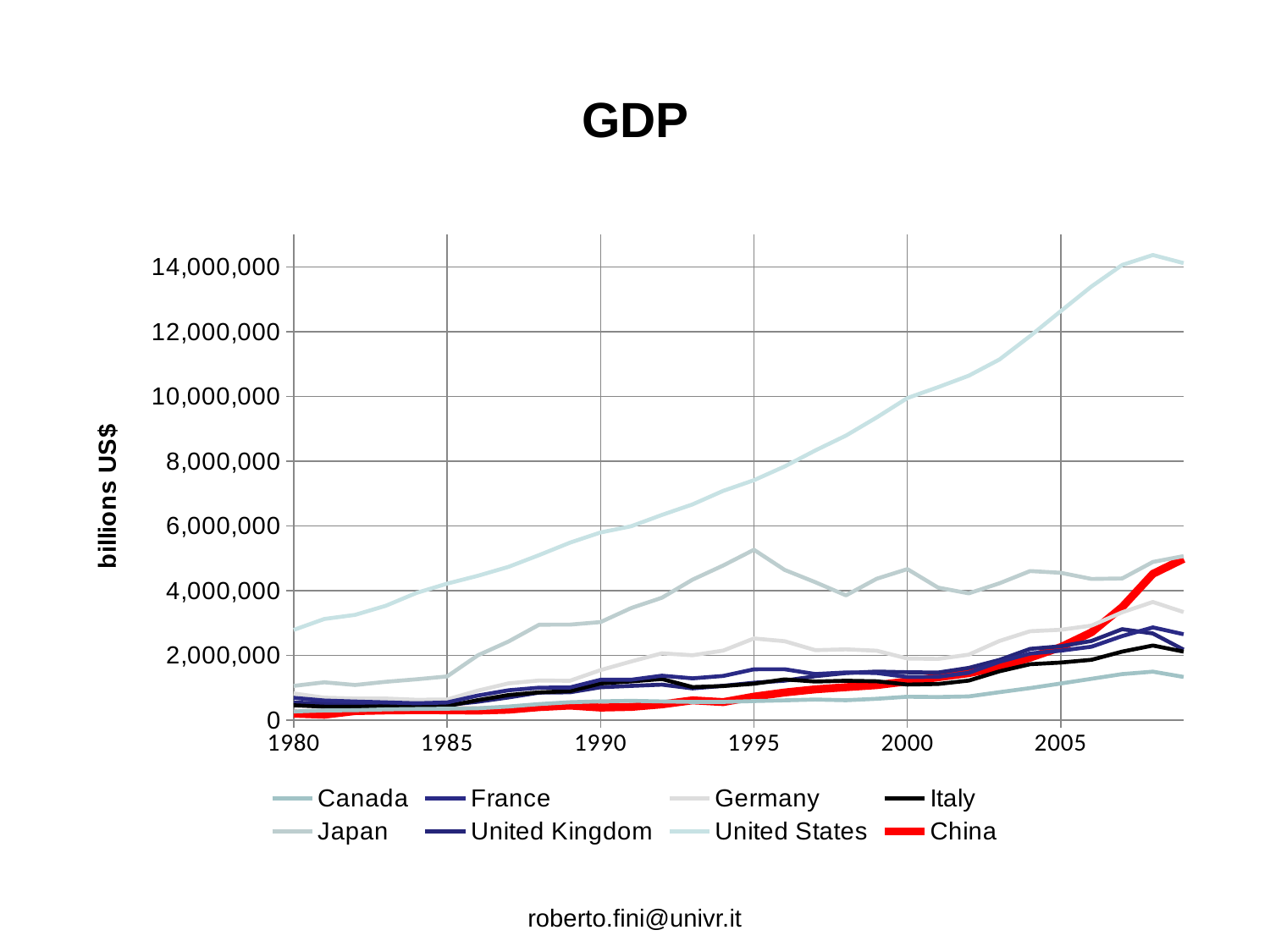
What is the title of the chart? GDP Does the GDP of the United States rise or fall from 1980 to 2005? rise Does the GDP of China rise or fall over the period shown? rise Is the value for Japan in 1995 greater or less than 4,000,000? greater Which country has the lowest GDP in 1980? China What kind of chart is shown on the slide? line chart In 2005, which is larger, the GDP of the United States or the GDP of Japan? United States How many series does the legend list? 8 What is the label on the vertical axis? billions US$ Which country has the highest GDP throughout the period shown? United States Is the value for China in 1990 greater or less than 2,000,000? less Is the value for the United States in 1995 greater or less than 6,000,000? greater